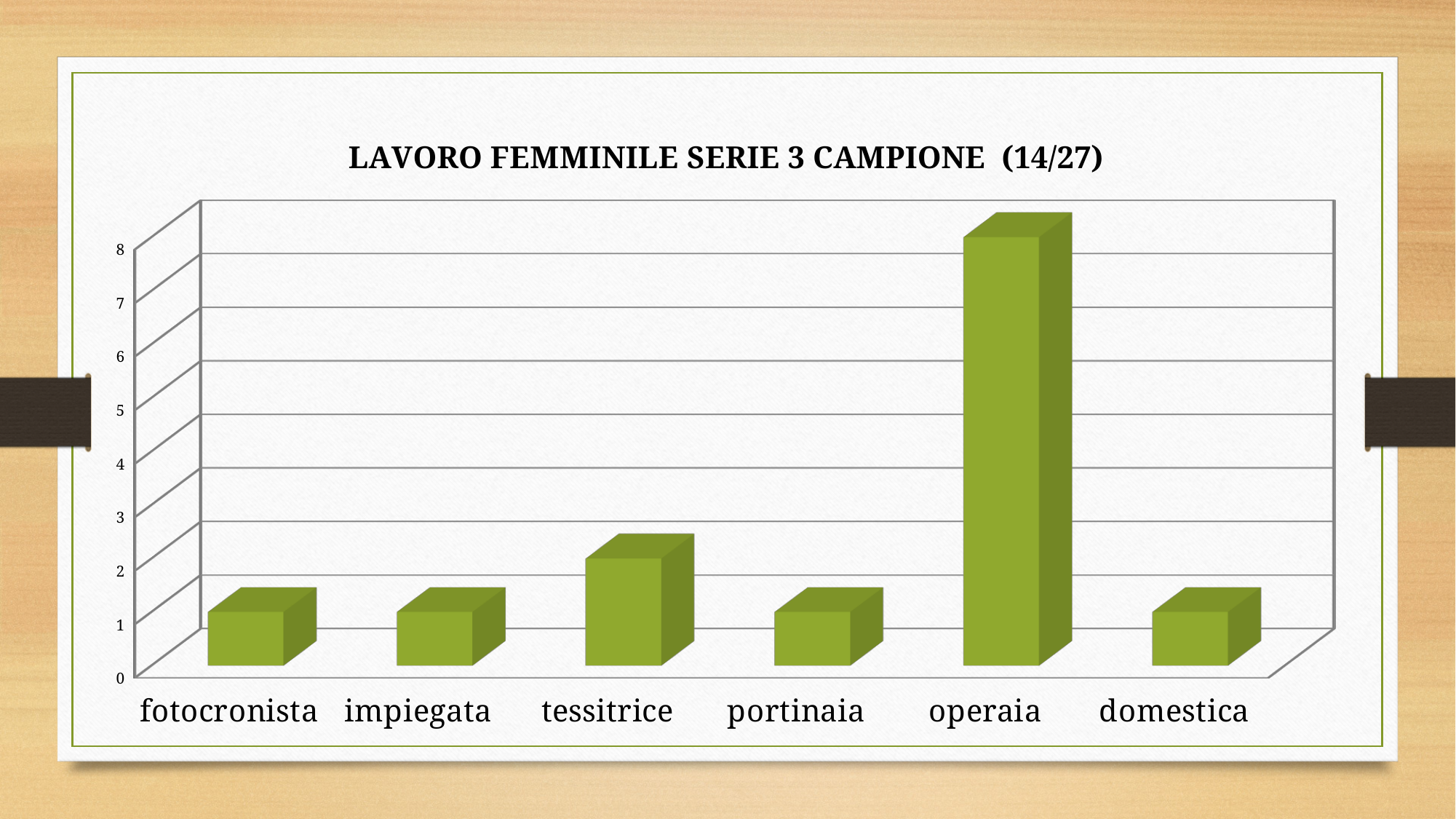
Is the value for tessitrice greater or less than 3? less Which is larger, the value for operaia or the value for domestica? operaia Is the value for domestica greater or less than 4? less Is the value for fotocronista greater or less than 2? less What colour are the bars in the chart? green Does the value rise or fall from tessitrice to portinaia? fall Which is larger, the value for tessitrice or the value for impiegata? tessitrice What kind of chart is shown on the slide? bar chart How many categories are shown on the x axis of the chart? 6 What is the title of the chart? LAVORO FEMMINILE SERIE 3 CAMPIONE (14/27) Which category has the highest value in the chart? operaia